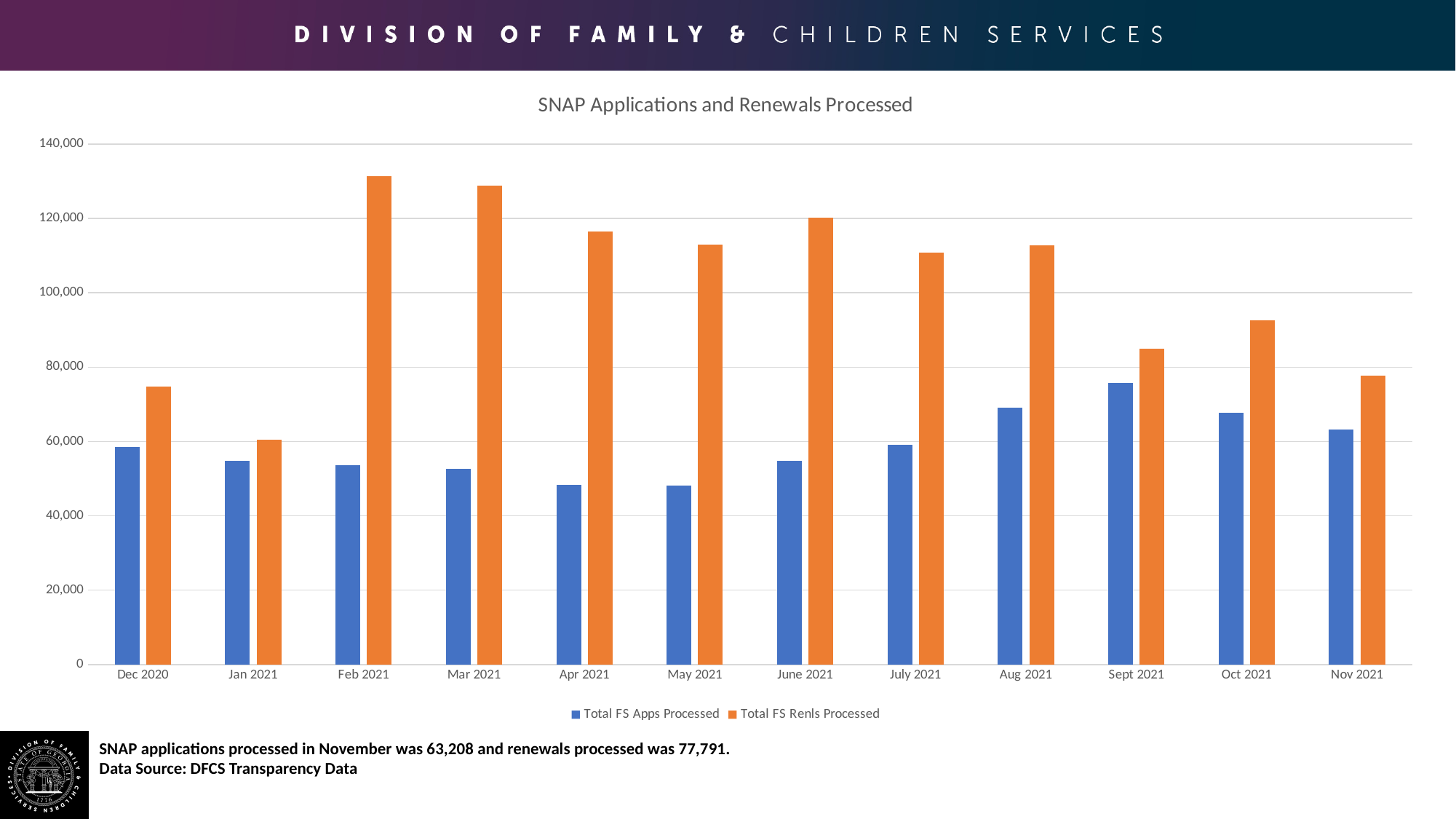
How many series does the legend list? 2 Which is larger for Aug 2021: Total FS Apps Processed or Total FS Renls Processed? Total FS Renls Processed What is the difference between Total FS Renls Processed and Total FS Apps Processed for Nov 2021? 14,583 Is the value of Total FS Renls Processed for Feb 2021 greater or less than 120,000? greater What is the title of the chart? SNAP Applications and Renewals Processed What type of chart is shown on the slide? Bar chart Is the value of Total FS Apps Processed for Apr 2021 greater or less than 60,000? less What is the value of Total FS Apps Processed for Nov 2021? 63,208 In which month is Total FS Apps Processed highest? Sept 2021 How many months are shown on the x axis of the chart? 12 What is the value of Total FS Renls Processed for Nov 2021? 77,791 In which month is Total FS Renls Processed lowest? Jan 2021